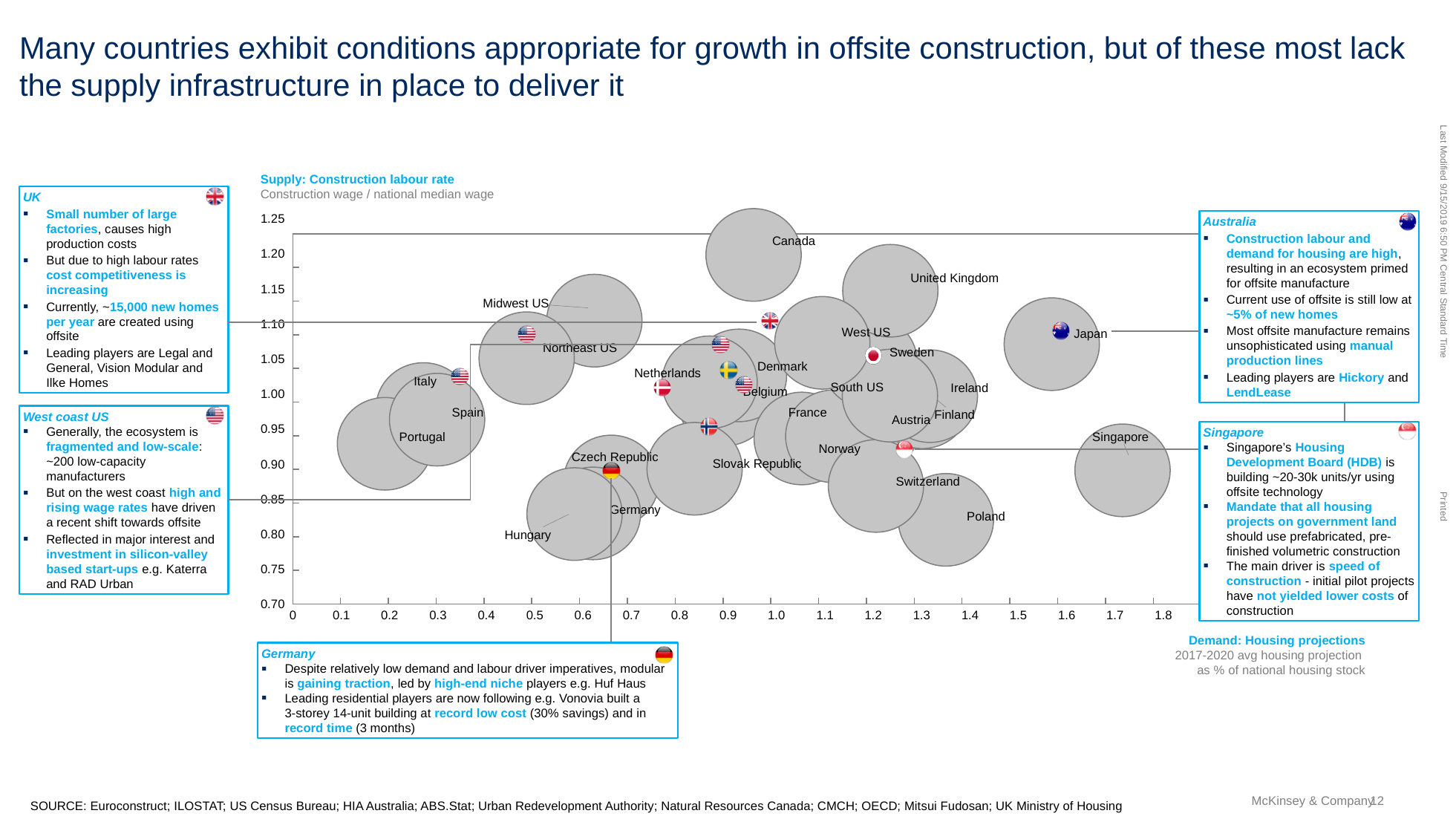
Is the construction labour rate (vertical axis) for Poland greater or less than 0.90? less Is the construction labour rate (vertical axis) for Canada greater or less than 1.10? greater What is the title of the vertical axis of the chart? Supply: Construction labour rate Is the construction labour rate (vertical axis) for Hungary greater or less than 0.95? less Which country has the highest construction labour rate (vertical axis) on the chart? Canada Which has the higher construction labour rate (vertical axis), Canada or Poland? Canada Which country is positioned furthest left on the horizontal (housing projections) axis? Portugal Which country is positioned furthest right on the horizontal (housing projections) axis? Singapore Which has the larger housing projection value (horizontal axis), Japan or Portugal? Japan What kind of chart is shown on the slide? Bubble chart